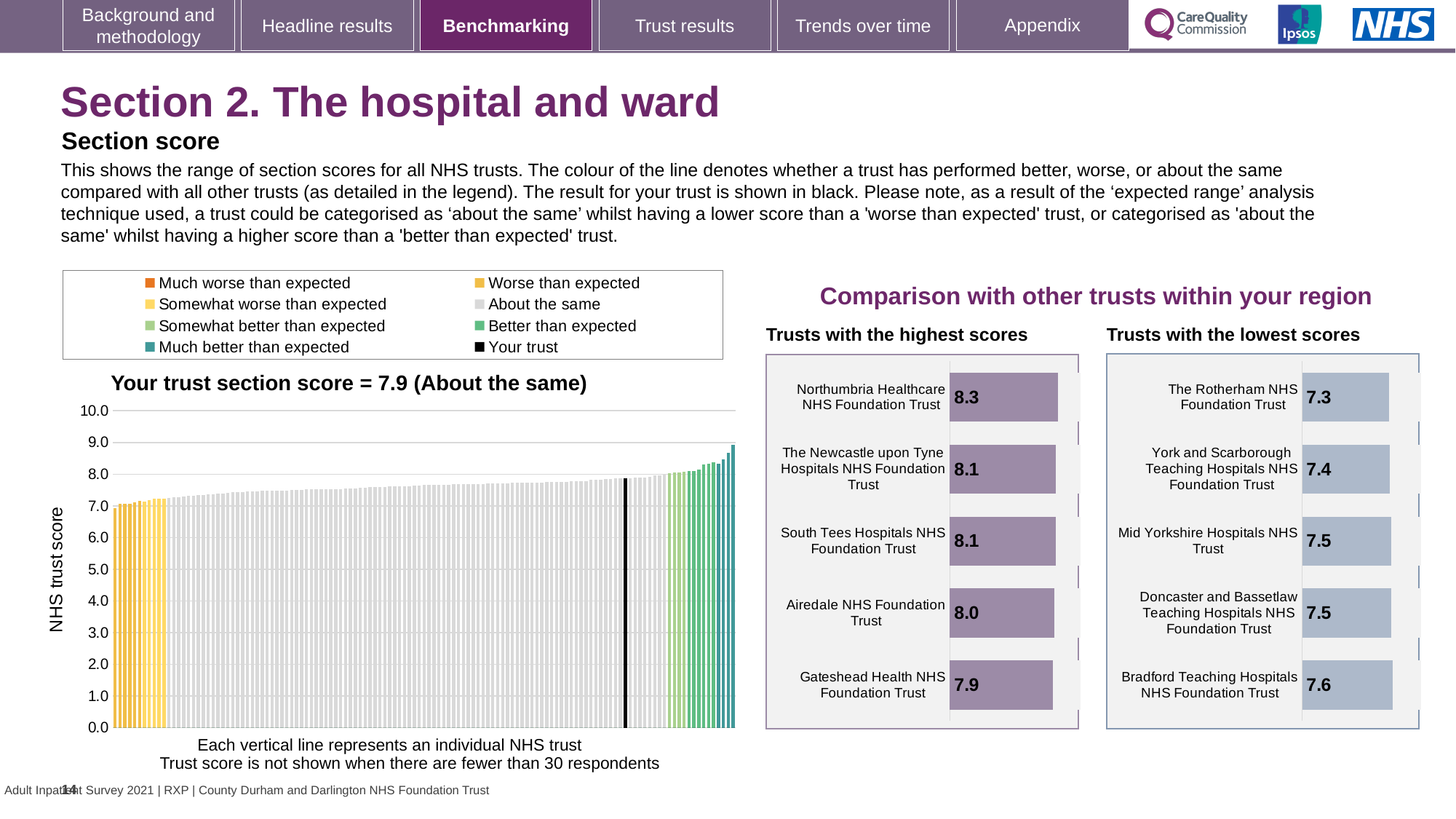
In the 'Trusts with the lowest scores' chart, which trust has the highest score? Bradford Teaching Hospitals NHS Foundation Trust In the 'Trusts with the highest scores' chart, how many trusts are shown? 5 In the chart titled 'Your trust section score = 7.9 (About the same)', do the bars rise or fall from left to right along the x axis? rise How many entries does the legend above the chart titled 'Your trust section score = 7.9 (About the same)' list? 8 In the 'Trusts with the highest scores' chart, what is the difference between the scores of Northumbria Healthcare NHS Foundation Trust and Gateshead Health NHS Foundation Trust? 0.4 What kind of chart is the chart titled 'Your trust section score = 7.9 (About the same)'? bar chart In the 'Trusts with the lowest scores' chart, what is the difference between the scores of Bradford Teaching Hospitals NHS Foundation Trust and The Rotherham NHS Foundation Trust? 0.3 In the 'Trusts with the highest scores' chart, which trust has the lowest score? Gateshead Health NHS Foundation Trust In the 'Trusts with the lowest scores' chart, which is larger: the score for York and Scarborough Teaching Hospitals NHS Foundation Trust or the score for Mid Yorkshire Hospitals NHS Trust? Mid Yorkshire Hospitals NHS Trust In the 'Trusts with the highest scores' chart, what is the score for Northumbria Healthcare NHS Foundation Trust? 8.3 In the 'Trusts with the lowest scores' chart, what is the score for The Rotherham NHS Foundation Trust? 7.3 In the chart titled 'Your trust section score = 7.9 (About the same)', what is the section score for your trust? 7.9